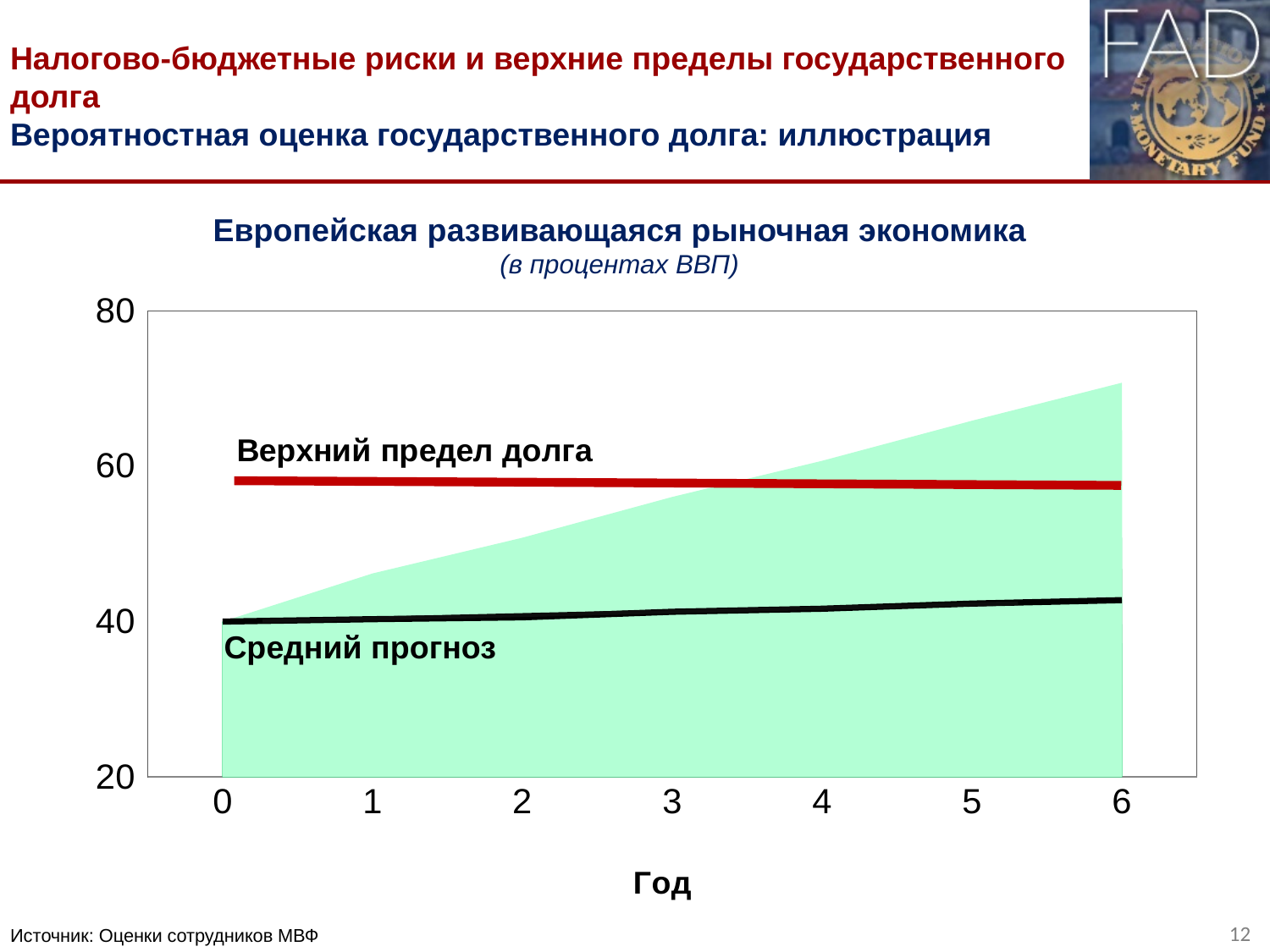
At year 6, which is higher: 'Верхний предел долга' or 'Средний прогноз'? Верхний предел долга What is the highest value shown on the y axis? 80 Is the value of 'Верхний предел долга' at year 0 greater or less than 40? greater Does the 'Средний прогноз' line rise or fall from year 0 to year 6? rises How many year ticks are shown on the x axis? 7 Is the value of 'Средний прогноз' at year 6 greater or less than 60? less What is the label of the x axis? Год What kind of chart is shown on the slide? combination area and line chart Is the top of the green shaded area at year 6 greater or less than 60? greater What is the title of the chart? Европейская развивающаяся рыночная экономика Does the upper edge of the green shaded area rise or fall from year 0 to year 6? rises